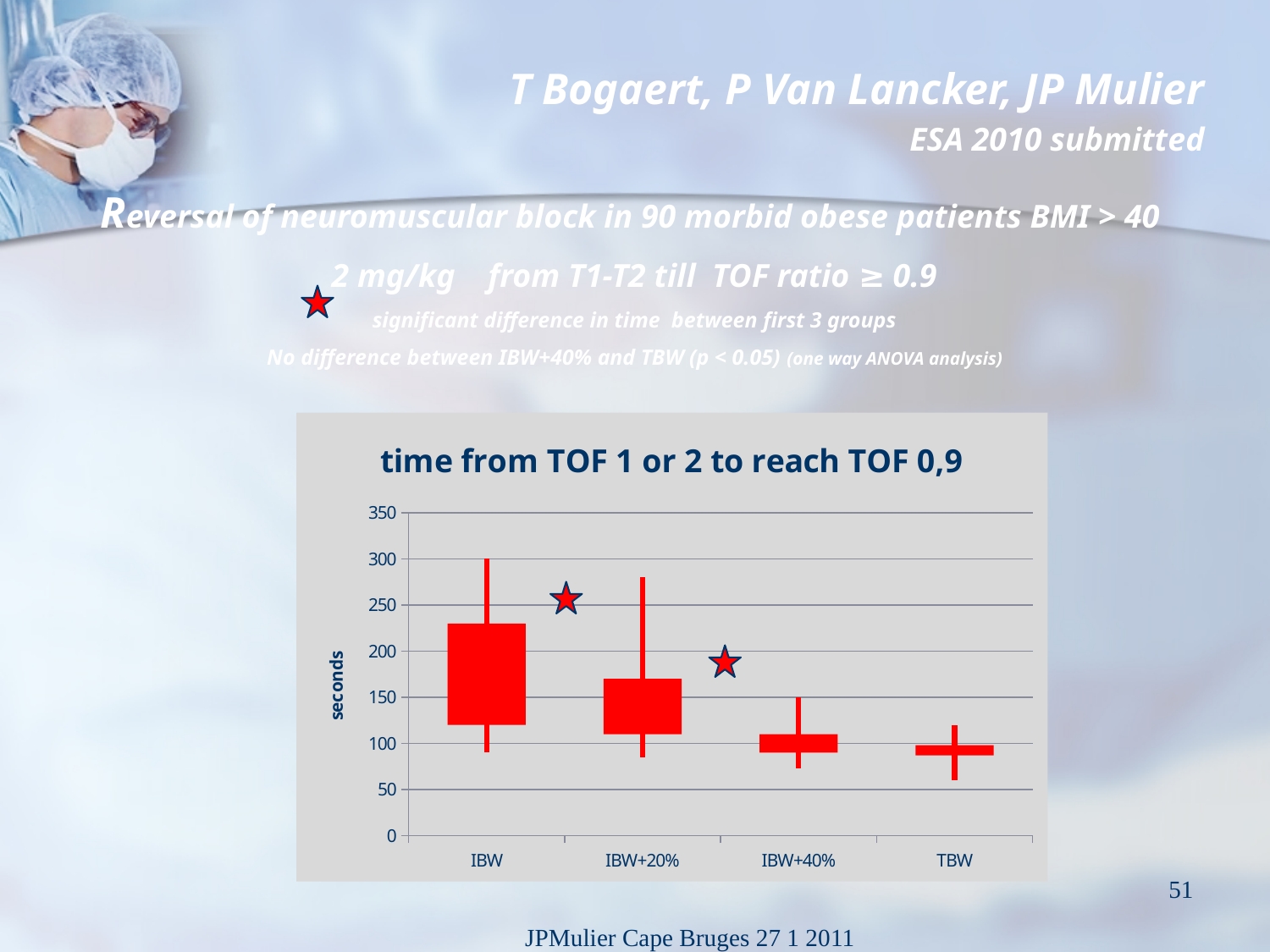
Is the top of the whisker for TBW greater or less than 150 seconds? less What is the label of the vertical axis? seconds Which category has the highest maximum value (top of the whisker)? IBW Which category has the lowest maximum value (top of the whisker)? TBW Is the top of the whisker for IBW+20% greater or less than 250 seconds? greater How many categories are shown on the x axis of the chart? 4 What is the title of the chart? time from TOF 1 or 2 to reach TOF 0,9 Which category shows a larger spread of values, IBW or TBW? IBW Is the top of the whisker for IBW+40% greater or less than 200 seconds? less What kind of chart is shown on the slide? box-and-whisker (box plot) chart Do the times generally rise or fall moving from IBW to TBW along the x axis? fall